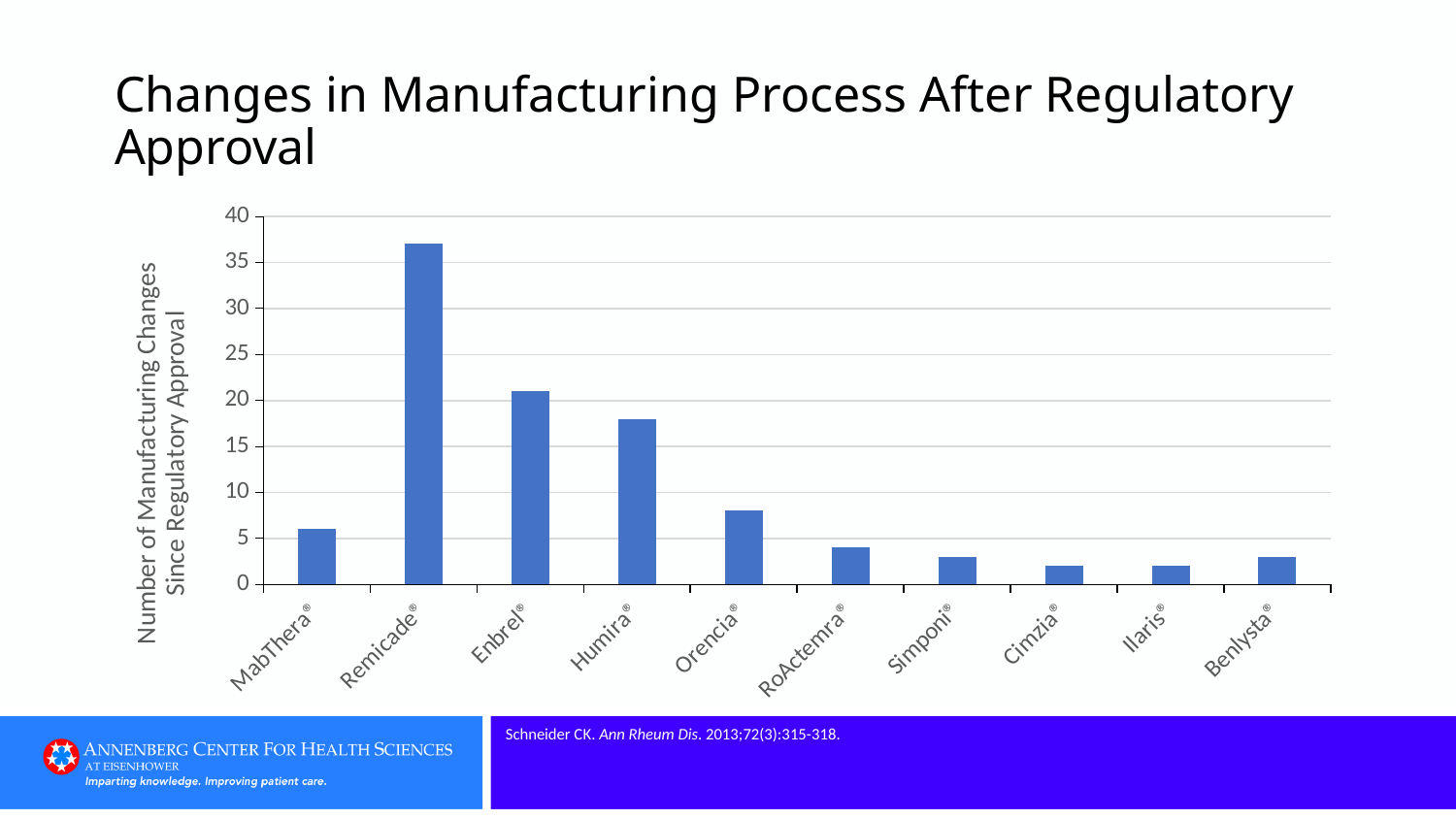
Which has more manufacturing changes, Enbrel or Humira? Enbrel Is the value for MabThera greater or less than 5? greater How many products are shown on the x axis of the chart? 10 Which product has the highest number of manufacturing changes since regulatory approval? Remicade What kind of chart is shown on the slide? bar chart Is the value for Orencia greater or less than 10? less Is the value for Humira greater or less than 20? less What is the label on the y axis of the chart? Number of Manufacturing Changes Since Regulatory Approval Which has more manufacturing changes, Orencia or MabThera? Orencia